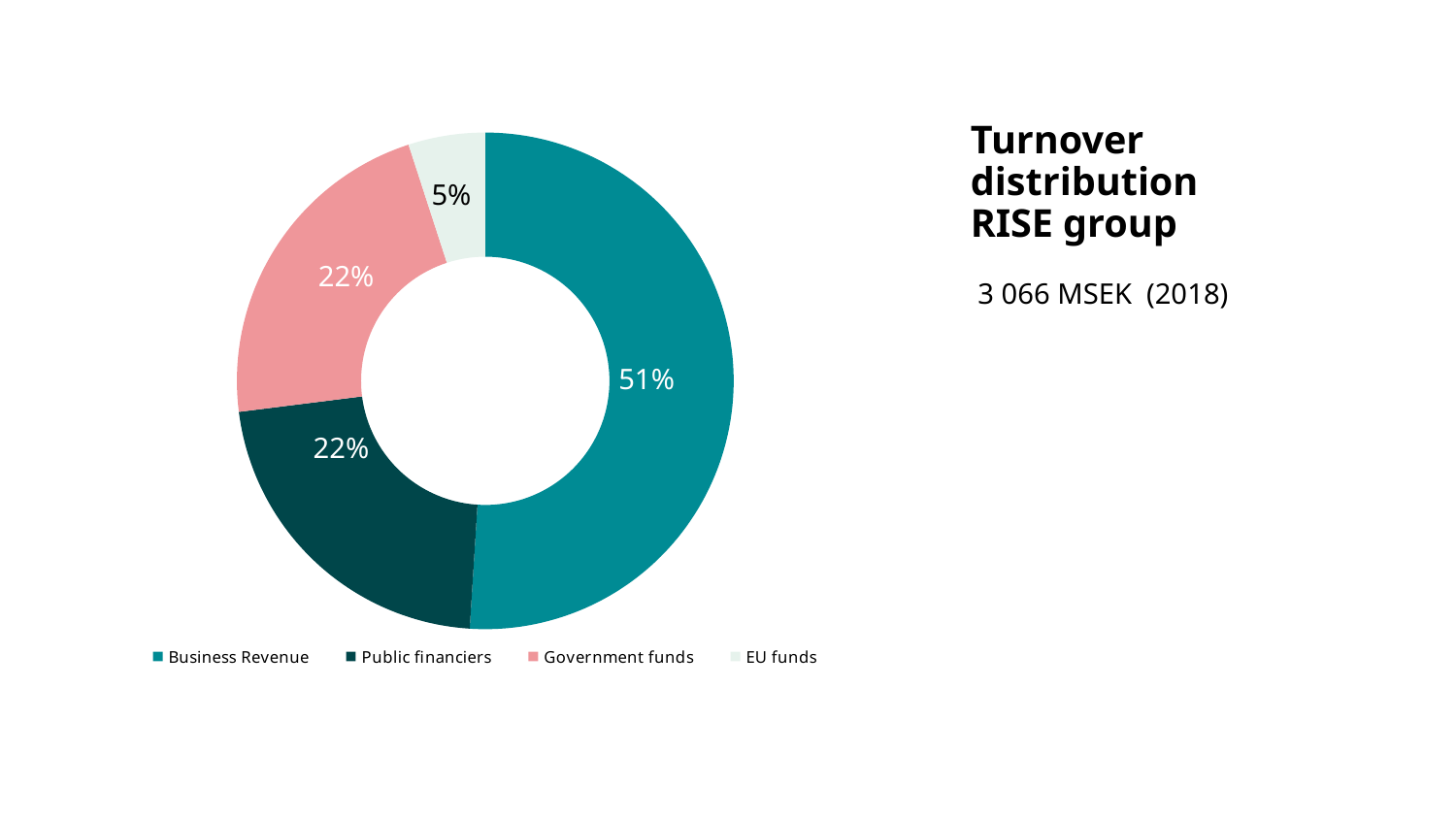
How many categories does the chart show? 4 What share of turnover comes from Public financiers? 22% What kind of chart is shown on the slide? Pie chart (doughnut) What is the difference in percentage points between Business Revenue and Public financiers? 29 Which is larger, the share for Business Revenue or the share for Government funds? Business Revenue Which category has the largest share of turnover? Business Revenue What is the difference in percentage points between Government funds and EU funds? 17 What share of turnover comes from Government funds? 22% What total turnover amount is stated next to the chart? 3 066 MSEK (2018) Which category has the smallest share of turnover? EU funds What share of turnover comes from Business Revenue? 51% What share of turnover comes from EU funds? 5%